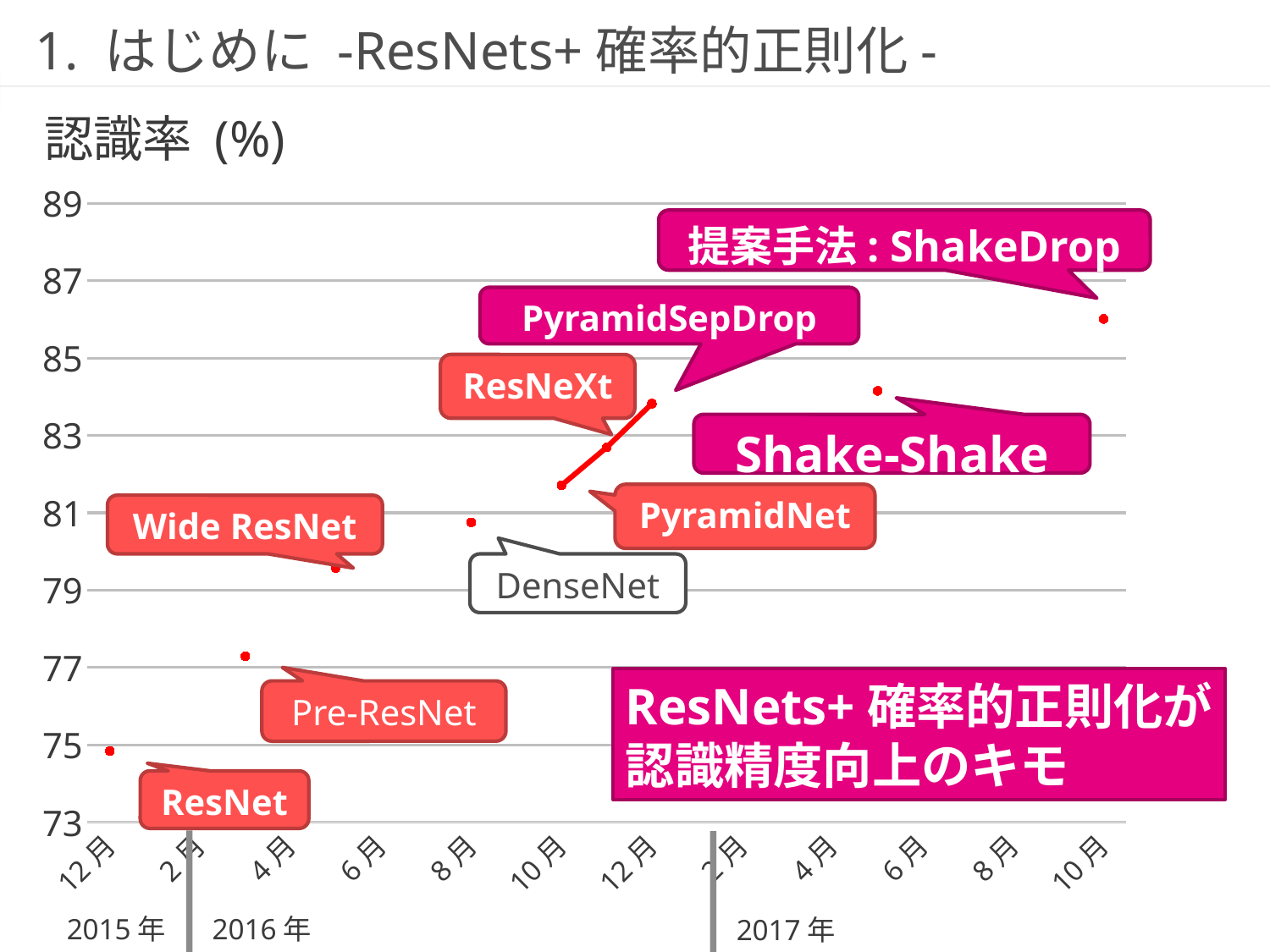
Is the recognition rate for ShakeDrop greater or less than 85? greater How many labeled data points are plotted on the chart? 9 What kind of chart is shown on the slide? line chart Do the recognition rates generally rise or fall over time along the x axis? rise Which method has the highest recognition rate on the chart? ShakeDrop Is the recognition rate for ShakeDrop greater or less than 87? less Is the recognition rate for Shake-Shake greater or less than 83? greater Which has a higher recognition rate, Shake-Shake or PyramidNet? Shake-Shake Which has a higher recognition rate, ShakeDrop or Shake-Shake? ShakeDrop Which method has the lowest recognition rate on the chart? ResNet